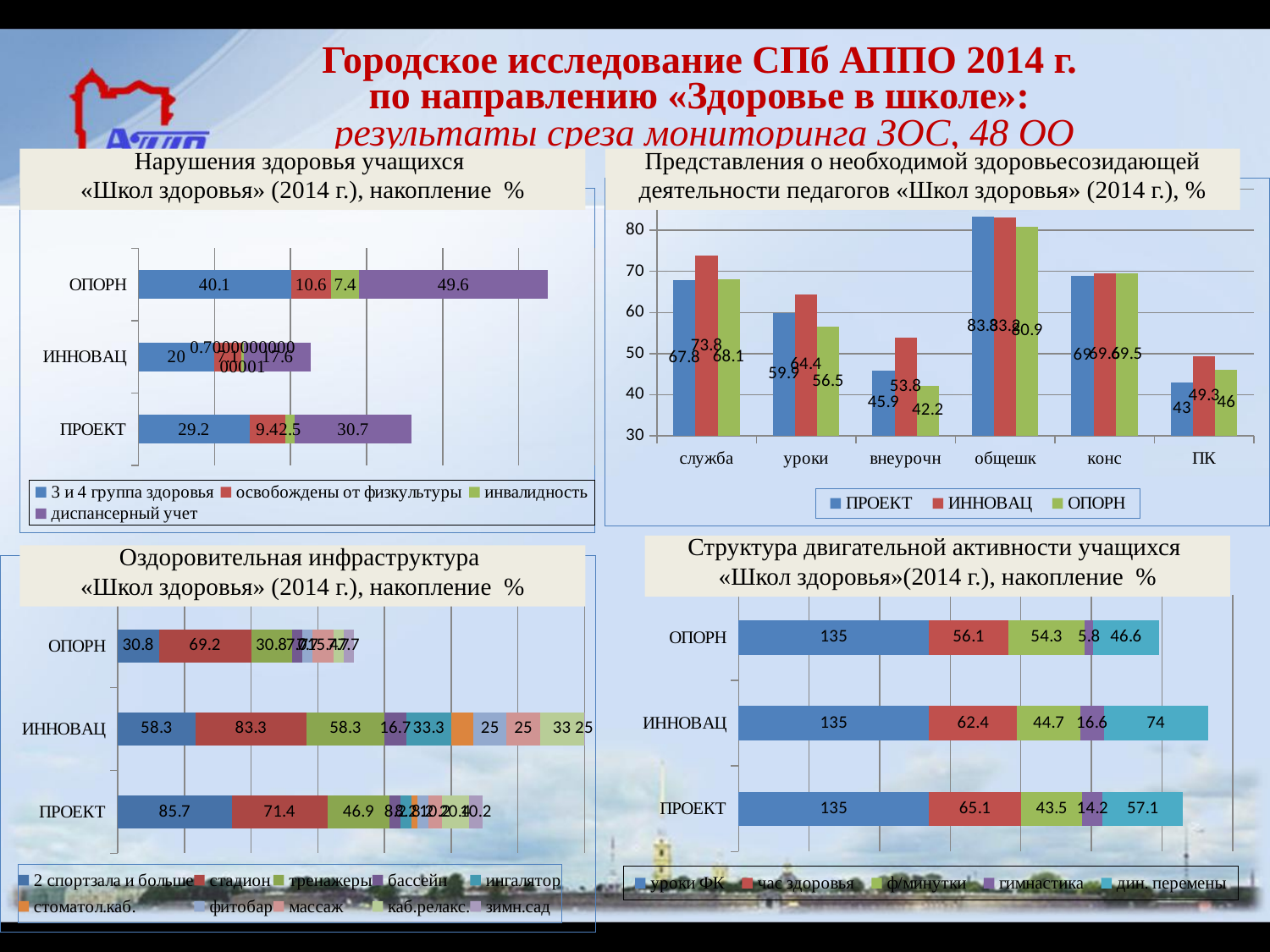
In the chart 'Представления о необходимой здоровьесозидающей деятельности педагогов', what is the value of ИННОВАЦ for 'служба'? 73.8 In the chart 'Представления о необходимой здоровьесозидающей деятельности педагогов', what is the value of ОПОРН for 'внеурочн'? 42.2 In the chart 'Нарушения здоровья учащихся', what is the value of '3 и 4 группа здоровья' for ОПОРН? 40.1 In the chart 'Оздоровительная инфраструктура', what is the value of '2 спортзала и больше' for ПРОЕКТ? 85.7 In the chart 'Структура двигательной активности учащихся', what is the total of the stacked bar for ОПОРН? 297.8 In the chart 'Нарушения здоровья учащихся', what is the value of 'диспансерный учет' for ПРОЕКТ? 30.7 In the chart 'Представления о необходимой здоровьесозидающей деятельности педагогов', what is the difference between ИННОВАЦ and ПРОЕКТ for 'уроки'? 4.5 In the chart 'Представления о необходимой здоровьесозидающей деятельности педагогов', which category has the highest values? общешк In the chart 'Нарушения здоровья учащихся', how many series does the legend list? 4 In the chart 'Структура двигательной активности учащихся', which group has the larger value for 'дин. перемены': ИННОВАЦ or ПРОЕКТ? ИННОВАЦ In the chart 'Представления о необходимой здоровьесозидающей деятельности педагогов', how many categories are on the x axis? 6 In the chart 'Структура двигательной активности учащихся', what is the value of 'час здоровья' for ИННОВАЦ? 62.4